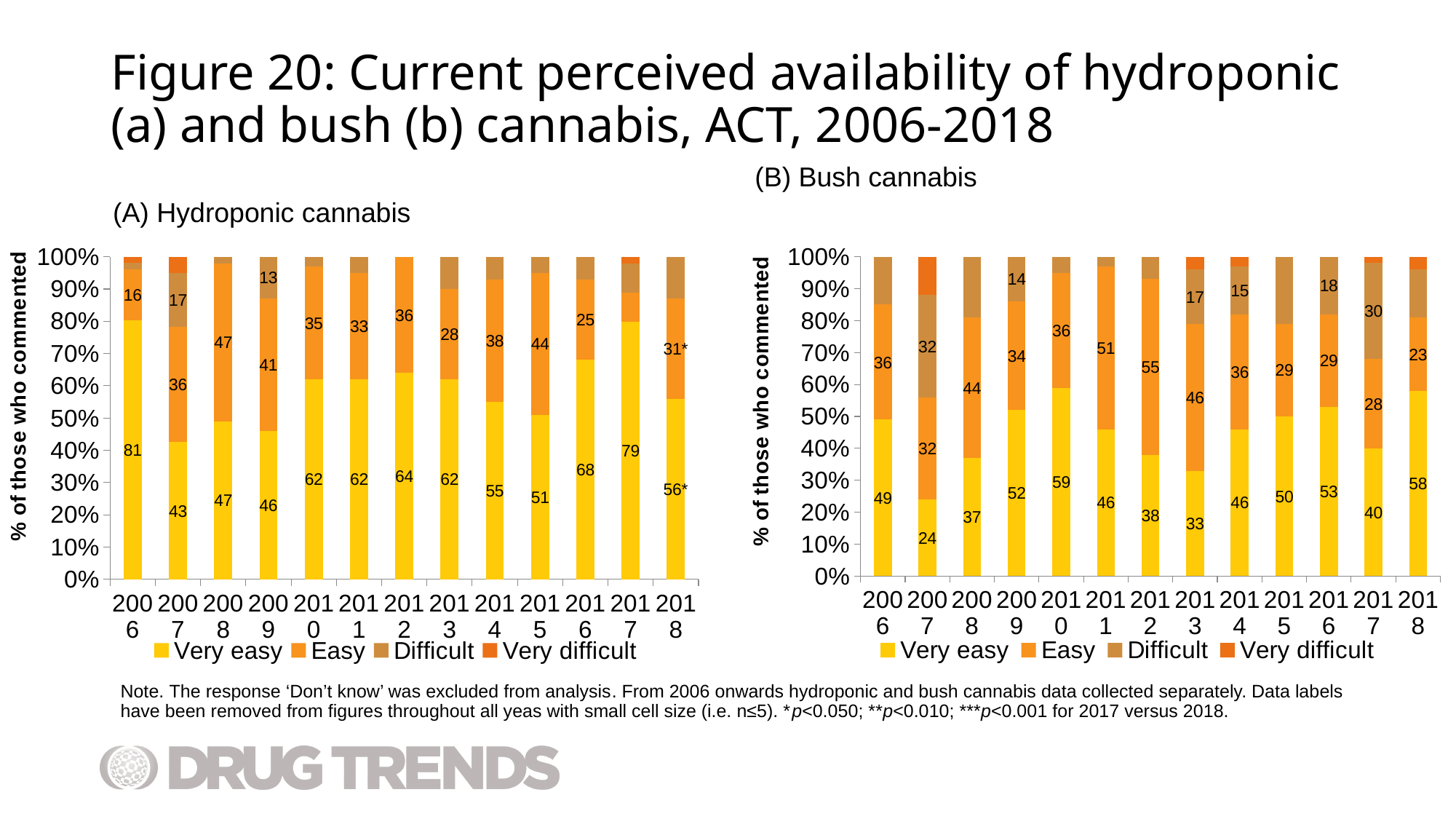
In chart (B) Bush cannabis, what is the 'Difficult' value for 2017? 30 How many years are shown on the x axis of chart (A) Hydroponic cannabis? 13 In chart (A) Hydroponic cannabis, which year has the lowest 'Very easy' value? 2007 In chart (B) Bush cannabis, which year has the highest 'Easy' value? 2012 What kind of chart is chart (A) Hydroponic cannabis? Stacked bar chart In chart (B) Bush cannabis, what is the value for 'Easy' in 2012? 55 How many series does the legend of chart (B) Bush cannabis list? 4 In chart (A) Hydroponic cannabis, what is the value for 'Very easy' in 2006? 81 In chart (A) Hydroponic cannabis, what is the difference between the 'Very easy' values for 2017 and 2018? 23 In chart (A) Hydroponic cannabis, what is the 'Difficult' value for 2009? 13 In chart (B) Bush cannabis, which year has the lowest 'Very easy' value? 2007 In chart (B) Bush cannabis, which is larger: the 'Very easy' value for 2008 or for 2009? 2009